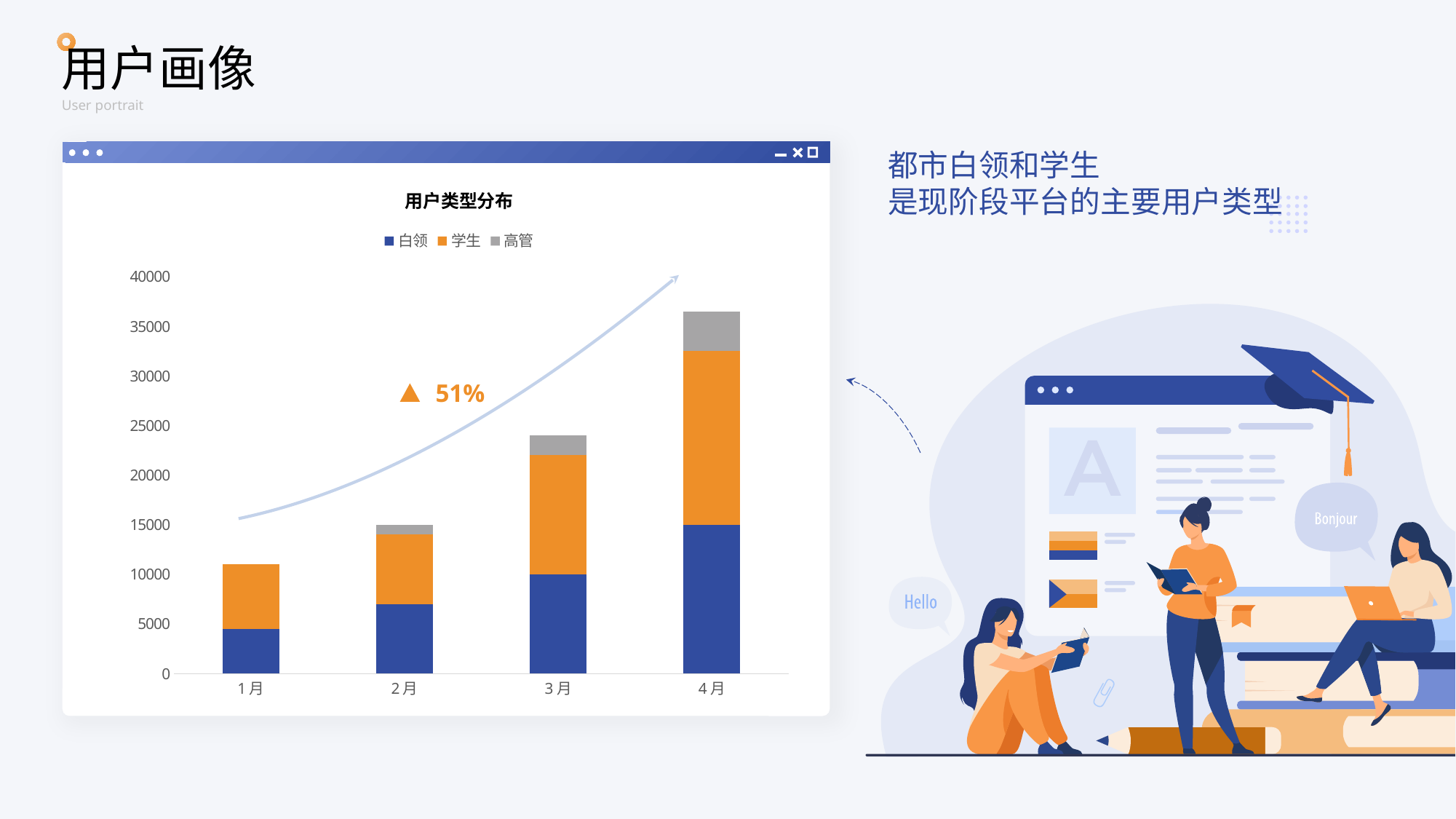
Is the total stacked bar for 4月 greater or less than 35000? greater Is the 白领 segment for 2月 greater or less than 5000? greater Which month has the tallest stacked bar? 4月 What is the title of the chart? 用户类型分布 Is the total stacked bar for 1月 greater or less than 15000? less Do the total bar heights rise or fall from 1月 to 4月? Rise Which month has the shortest stacked bar? 1月 Which month has a larger total bar, 2月 or 3月? 3月 What kind of chart is shown on the slide? Stacked bar chart How many series does the chart legend list? 3 How many months are shown on the x axis of the chart? 4